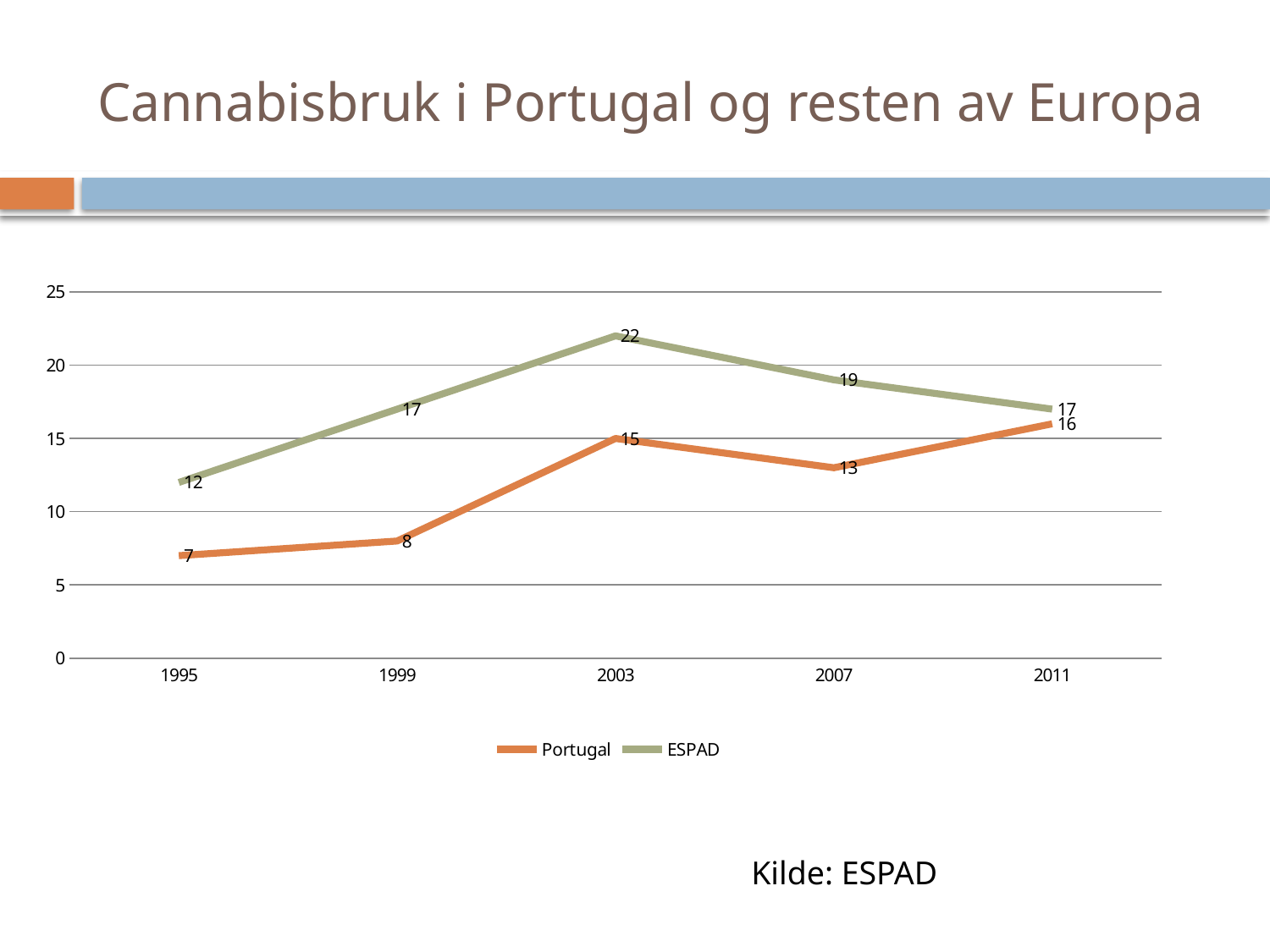
What is the value for Portugal in 2003? 15 How many series does the legend list? 2 In which year is the Portugal series lowest? 1995 What is the value for ESPAD in 1999? 17 What is the difference between the ESPAD and Portugal values in 2007? 6 What is the value for Portugal in 1995? 7 Which is larger in 2011, the Portugal value or the ESPAD value? ESPAD What kind of chart is shown on the slide? Line chart Does the ESPAD series rise or fall from 2003 to 2011? Fall What is the title of the slide? Cannabisbruk i Portugal og resten av Europa In which year is the ESPAD series highest? 2003 How many years are shown on the x axis? 5